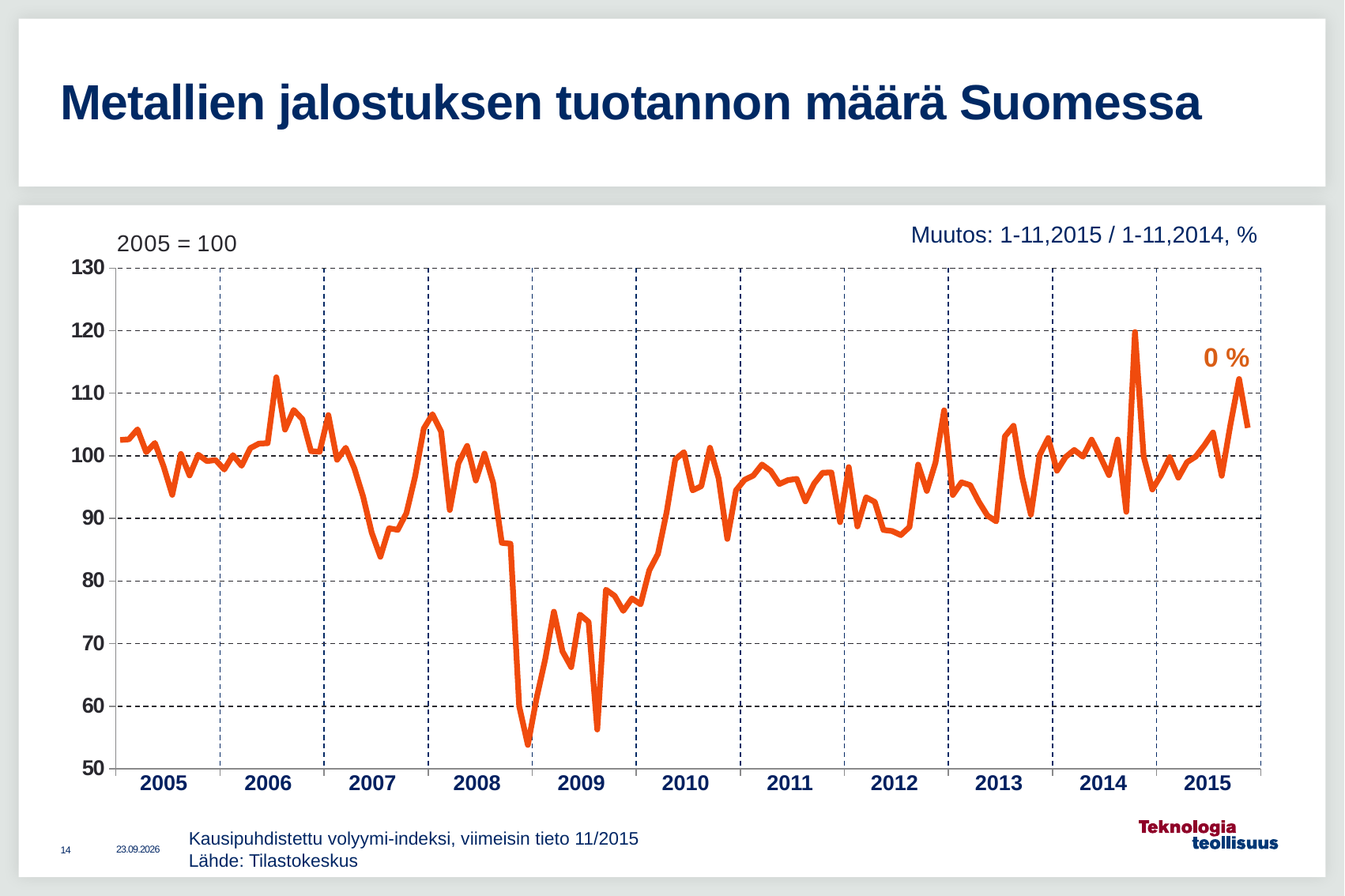
In which year does the line reach its lowest point? 2008 What percentage change is annotated on the chart for 1-11,2015 / 1-11,2014? 0 % Is the highest value of the line in 2014 greater or less than 110? greater What kind of chart is shown on the slide? line chart What base year and value is the index set to, as noted above the chart? 2005 = 100 Is the lowest value of the line in 2009 greater or less than 60? less Is the value at the start of 2005 greater or less than 100? greater Does the line rise or fall from the start of 2009 to the start of 2010? rise What is the title of the chart on the slide? Metallien jalostuksen tuotannon määrä Suomessa In which year does the line reach its highest peak? 2014 Does the line rise or fall from the start of 2008 to the start of 2009? fall How many years are labelled on the x axis of the chart? 11